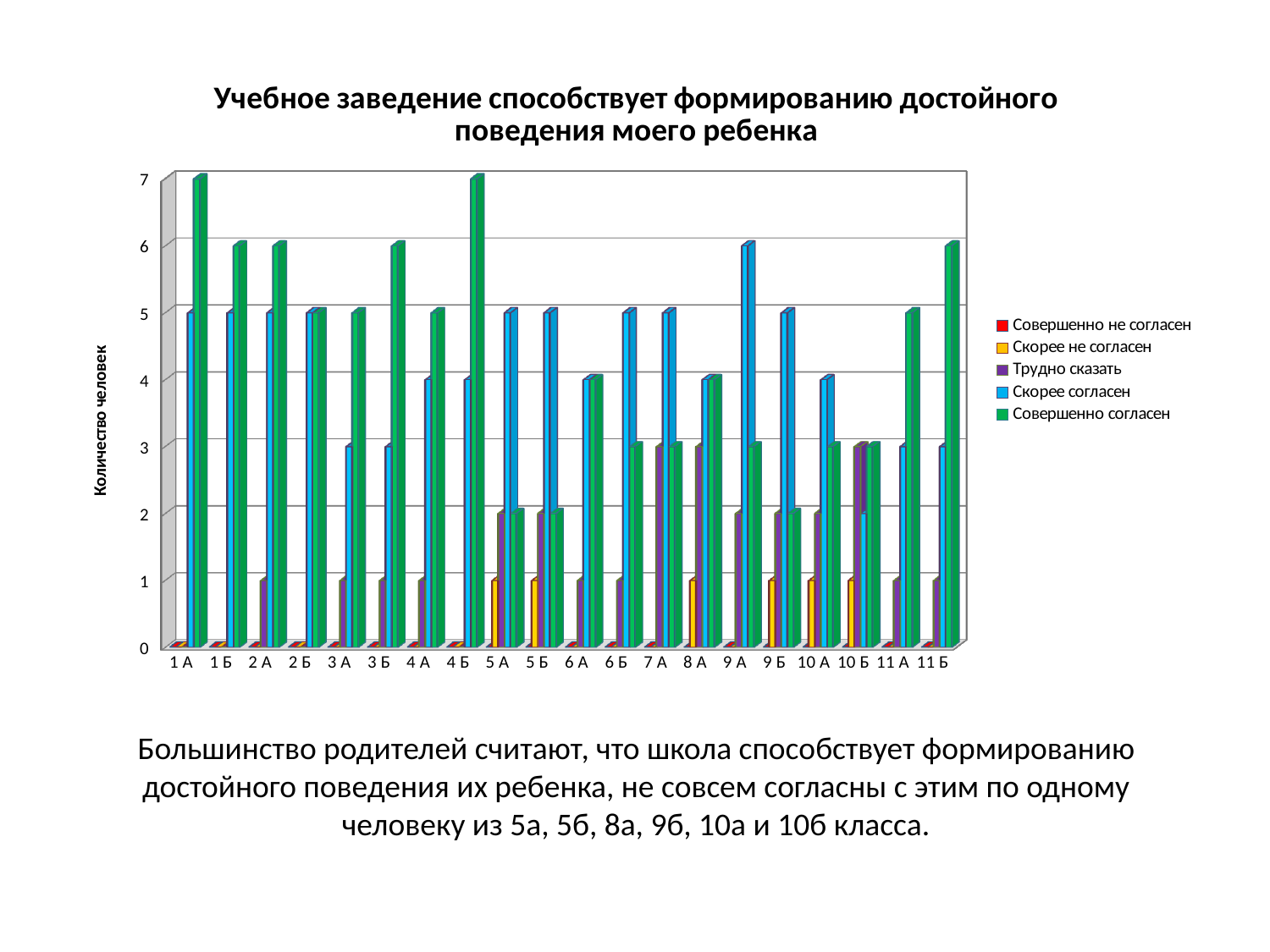
What is the value of "Совершенно согласен" for class 4 Б? 7 For which class is the "Скорее согласен" value highest? 9 А Is the value of "Скорее согласен" for class 1 Б greater or less than 3? greater How many series does the legend list? 5 What is the label of the vertical axis? Количество человек Which is larger: "Совершенно согласен" for class 1 А or for class 5 Б? 1 А What kind of chart is shown on the slide? bar chart What is the title of the chart? Учебное заведение способствует формированию достойного поведения моего ребенка Is the value of "Совершенно согласен" for class 5 А greater or less than 4? less What is the value of "Скорее согласен" for class 9 А? 6 How many class categories are shown along the x axis? 20 What is the value of "Совершенно согласен" for class 1 А? 7